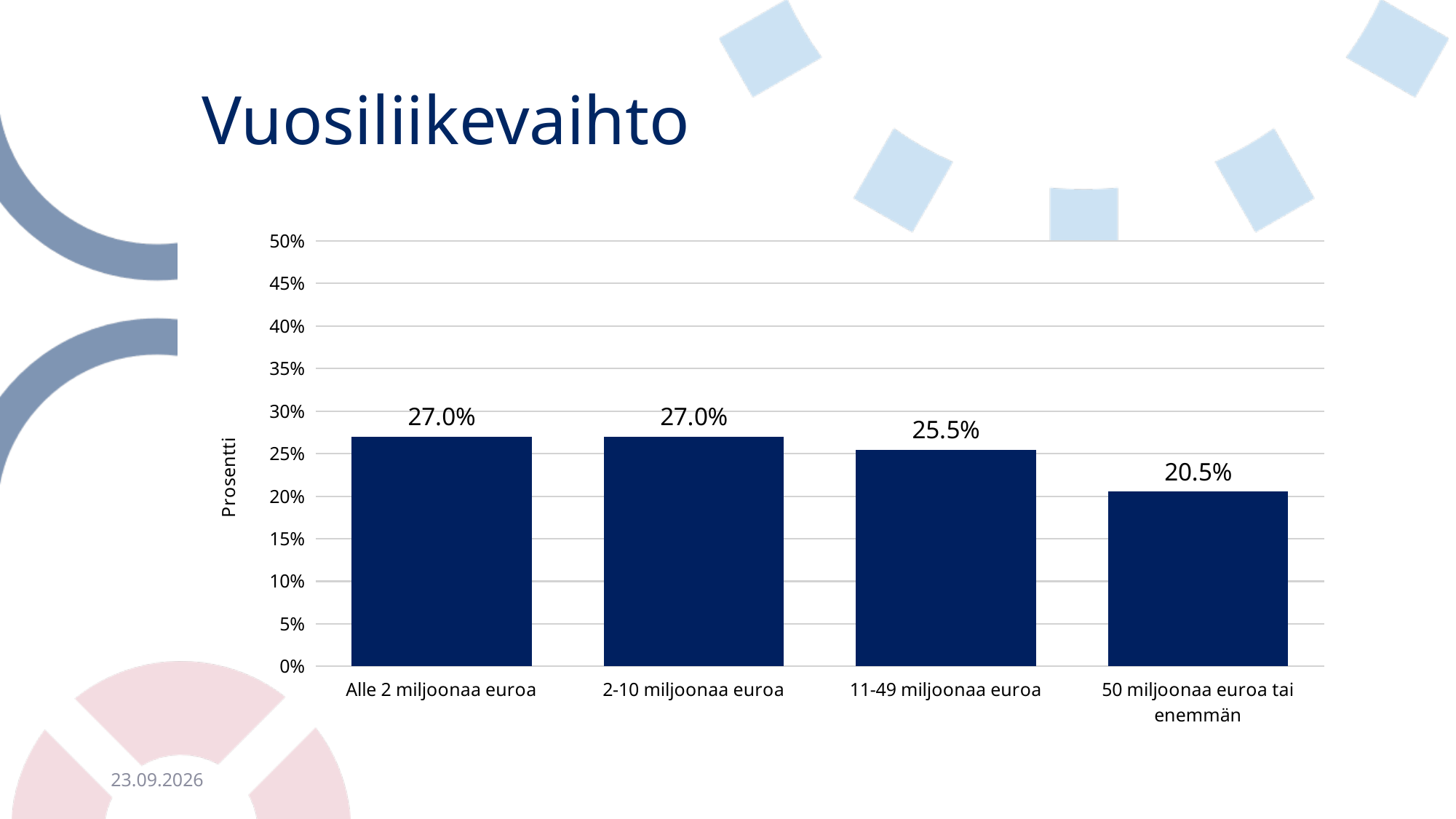
What is the value for "11-49 miljoonaa euroa"? 25.5% What is the label of the vertical axis? Prosentti What is the value for "50 miljoonaa euroa tai enemmän"? 20.5% What is the difference between the values for "11-49 miljoonaa euroa" and "50 miljoonaa euroa tai enemmän"? 5.0% What is the value for "Alle 2 miljoonaa euroa"? 27.0% What kind of chart is shown on the slide? bar chart Which is larger, the value for "11-49 miljoonaa euroa" or the value for "50 miljoonaa euroa tai enemmän"? 11-49 miljoonaa euroa Is the value for "2-10 miljoonaa euroa" greater or less than 25%? greater What is the difference between the values for "2-10 miljoonaa euroa" and "11-49 miljoonaa euroa"? 1.5% Do the values rise or fall from left to right along the x axis? fall How many categories are shown on the x axis? 4 Which category has the lowest value? 50 miljoonaa euroa tai enemmän